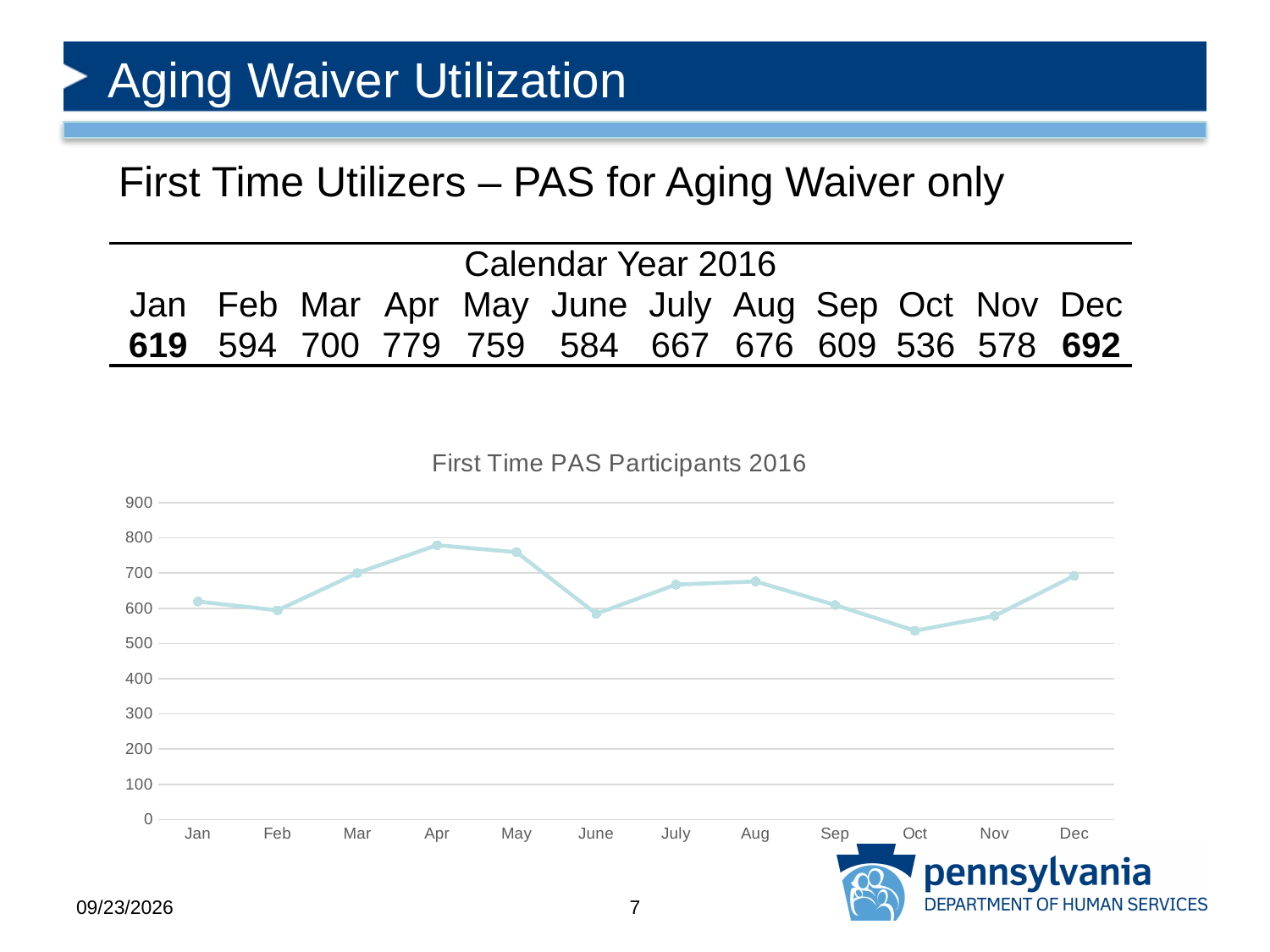
What is the title of the chart? First Time PAS Participants 2016 What is the difference between the values for Apr and Oct? 243 Which month has the lowest value in the chart? Oct Is the value for May greater or less than 700? greater Which is larger, the value for Mar or the value for June? Mar What is the value for Oct? 536 Which month has the highest value in the chart? Apr What is the value for Apr? 779 Do the values rise or fall from Sep to Oct? fall How many months are plotted on the x axis of the chart? 12 What is the value for Dec? 692 What type of chart is shown on the slide? line chart